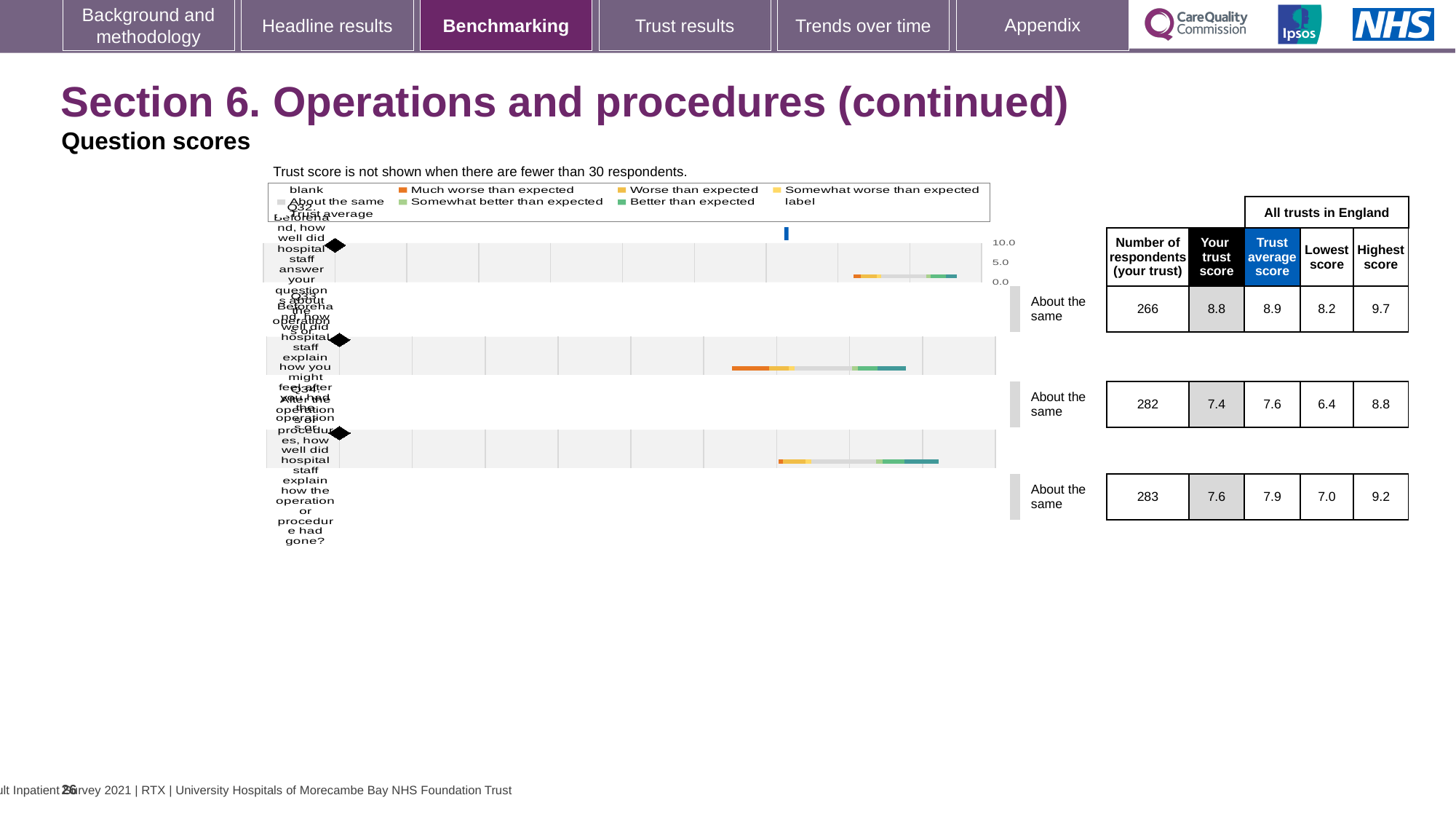
Is the trust score marker on the top chart (Q32) greater or less than 5.0? greater For the middle chart (Q33), what is the difference between the highest score and the lowest score shown in the table? 2.4 What is the highest value shown on the score axis of the top chart? 10.0 Which has the larger 'Your trust score': the top chart (Q32) or the bottom chart (Q34)? Q32 What kind of chart is used for the three question-score charts on the slide? bar chart How many question-score charts are shown on the slide? 3 For the top chart (Q32), what is the 'Your trust score' value shown in the table beside it? 8.8 For the middle chart (Q33), what is the 'Trust average score' shown in the table beside it? 7.6 For the bottom chart (Q34), what is the number of respondents shown in the table beside it? 283 What benchmark category label is shown to the right of each of the three charts? About the same Which of the three question charts has the highest 'Your trust score'? Q32